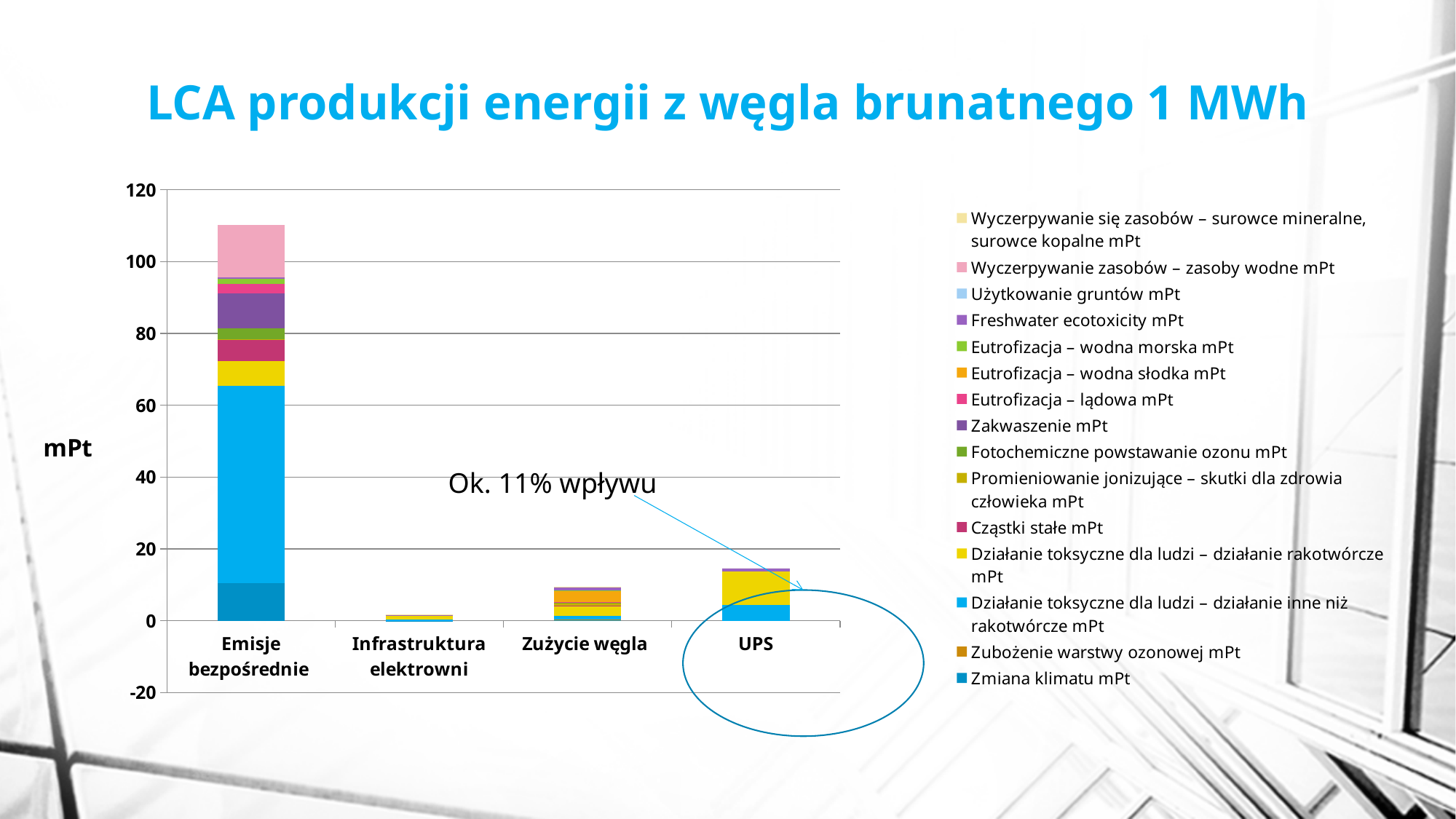
How many categories are shown on the x axis of the chart? 4 Which has a larger total stacked value, Zużycie węgla or Infrastruktura elektrowni? Zużycie węgla Is the total value for Zużycie węgla greater or less than 20? less Which category has the highest total stacked value? Emisje bezpośrednie Which category has the lowest total stacked value? Infrastruktura elektrowni Is the total value for UPS greater or less than 20? less What annotation text points to the UPS bar? Ok. 11% wpływu What kind of chart is shown on the slide? Stacked bar chart Which has a larger total stacked value, Emisje bezpośrednie or UPS? Emisje bezpośrednie Is the total value for Emisje bezpośrednie greater or less than 100? greater How many series does the chart's legend list? 15 What is the title of the slide's chart? LCA produkcji energii z węgla brunatnego 1 MWh